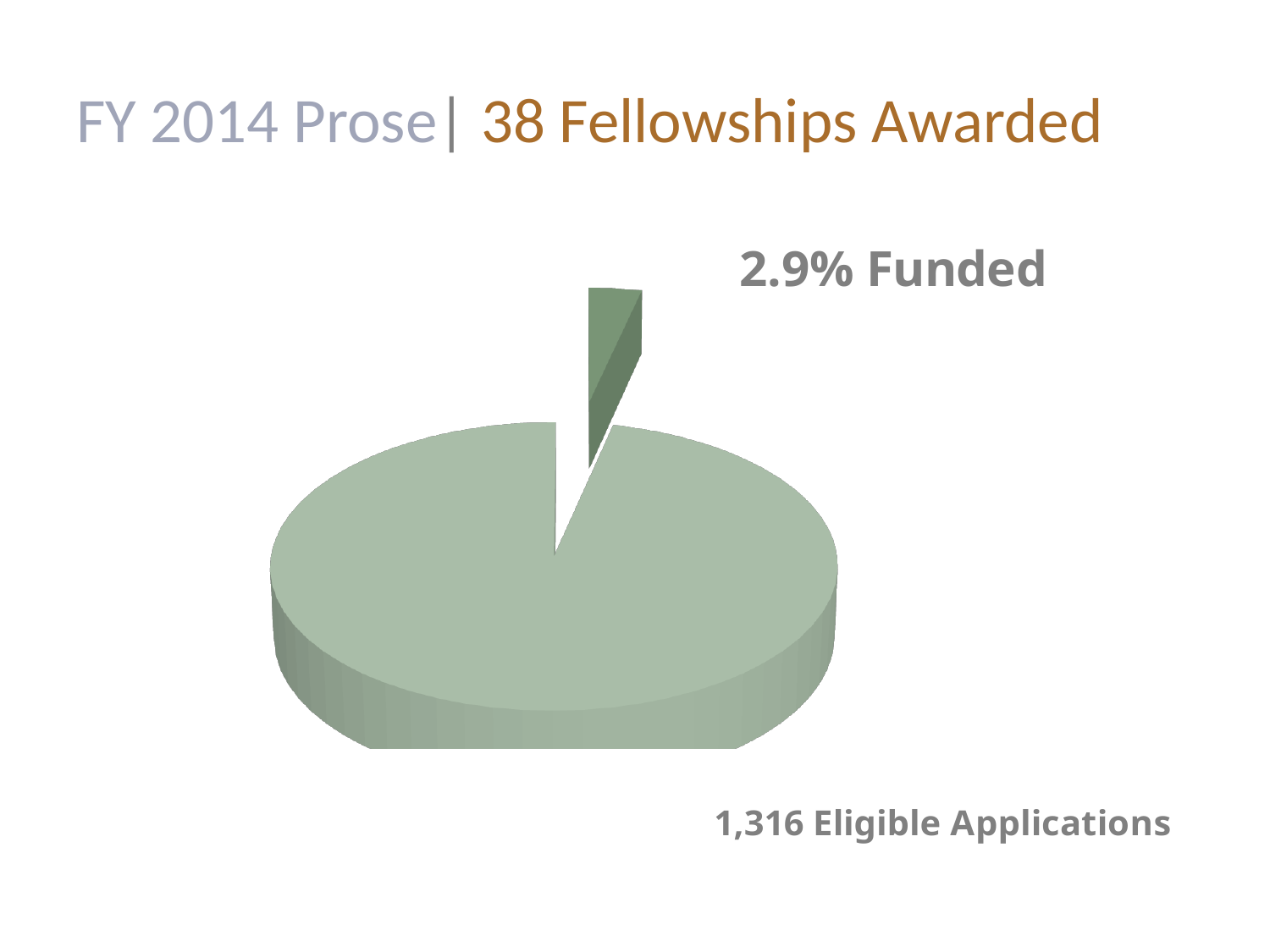
Which slice of the pie is larger, the funded slice or the eligible applications slice? eligible applications What is the title of the slide? FY 2014 Prose | 38 Fellowships Awarded How many fellowships were awarded according to the slide title? 38 How many eligible applications are shown on the slide? 1,316 What kind of chart is shown on the slide? pie chart Which fiscal year does the chart refer to? FY 2014 What share of the pie does the funded slice represent? 2.9% Is the funded share of the pie greater or less than 10%? less How many slices does the pie chart have? 2 Which slice of the pie is the smallest? 2.9% Funded